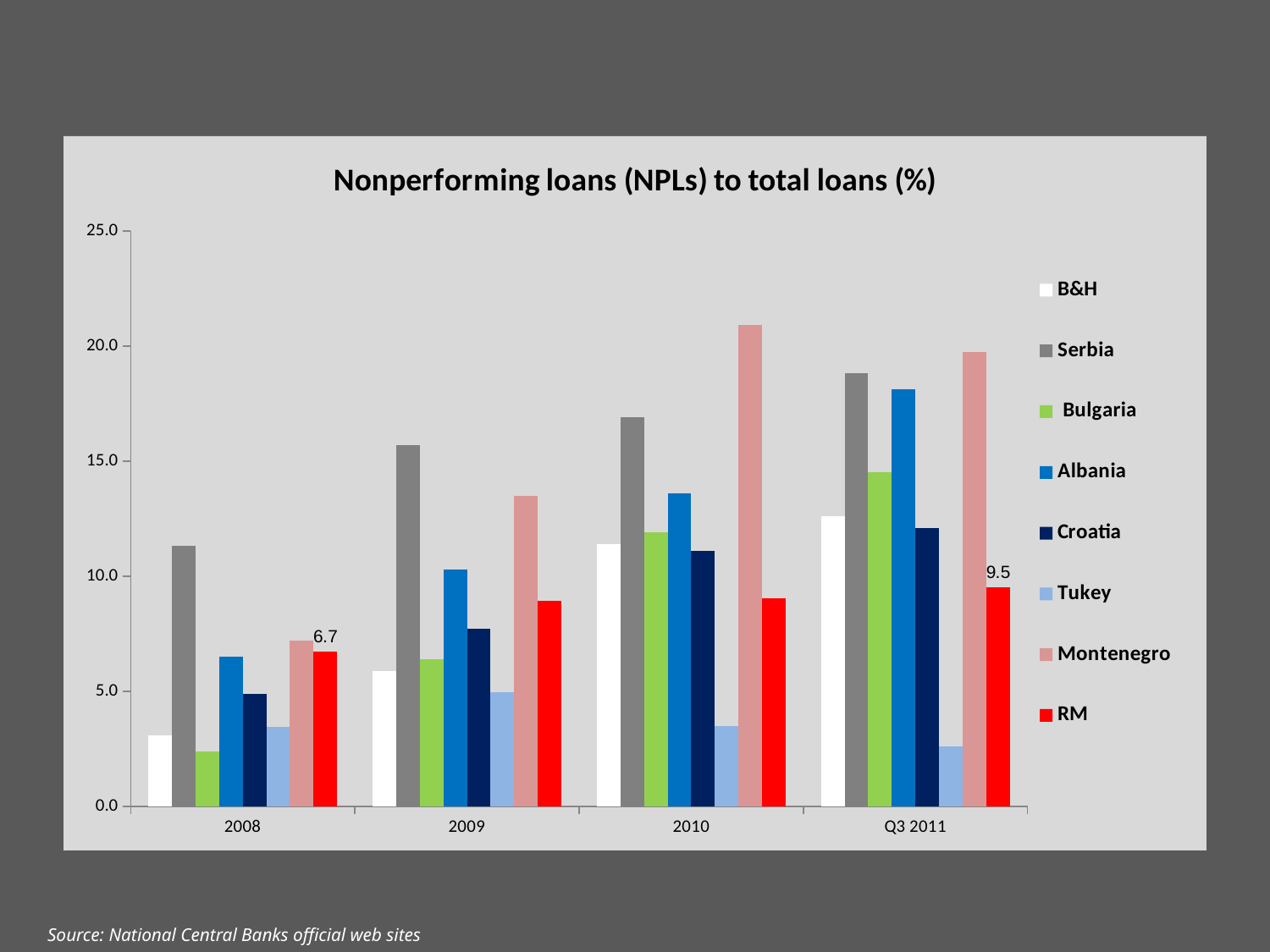
In 2009, which is larger: the value for Serbia or the value for Albania? Serbia What is the value for RM in 2008? 6.7 How many time periods are shown on the x axis? 4 What is the value for RM in Q3 2011? 9.5 Which country has the highest value in 2010? Montenegro Which country has the lowest value in Q3 2011? Tukey How many series does the legend list? 8 By how much did the RM value increase from 2008 to Q3 2011? 2.8 Is the value for Albania in Q3 2011 greater or less than 15.0? greater What kind of chart is shown on the slide? Bar chart What is the title of the chart? Nonperforming loans (NPLs) to total loans (%) Does the value for Serbia rise or fall from 2008 to Q3 2011? Rise